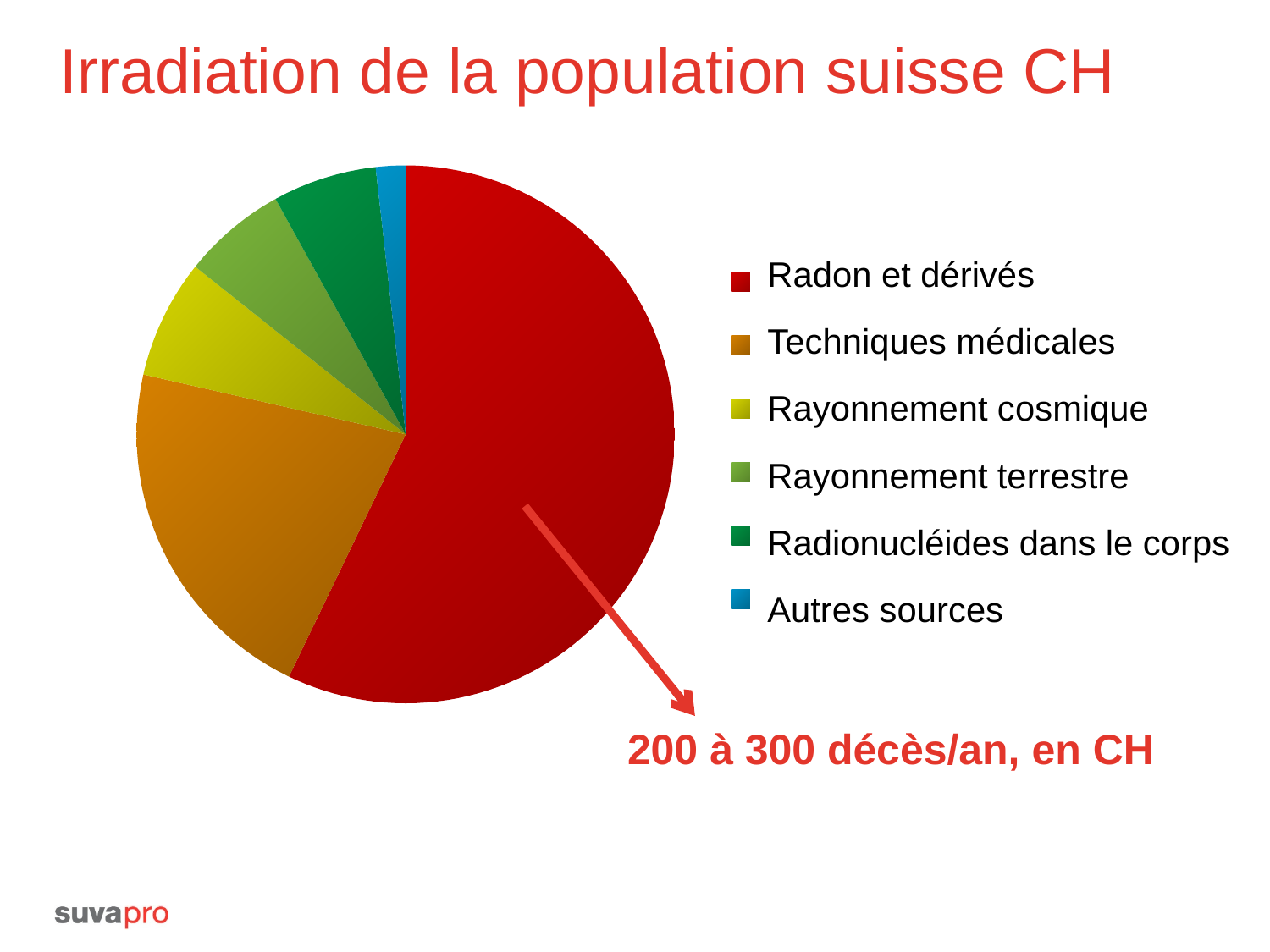
Which category has the largest slice of the pie? Radon et dérivés Which slice is larger: Radionucléides dans le corps or Autres sources? Radionucléides dans le corps What kind of chart is shown on the slide? pie chart What is the title of the slide containing the pie chart? Irradiation de la population suisse CH Which category is the second largest slice of the pie? Techniques médicales Which slice is larger: Radon et dérivés or Techniques médicales? Radon et dérivés Which category has the smallest slice of the pie? Autres sources How many entries does the legend list? 6 What colour is the slice for Radon et dérivés? red Which slice is larger: Rayonnement cosmique or Autres sources? Rayonnement cosmique How many categories does the pie chart show? 6